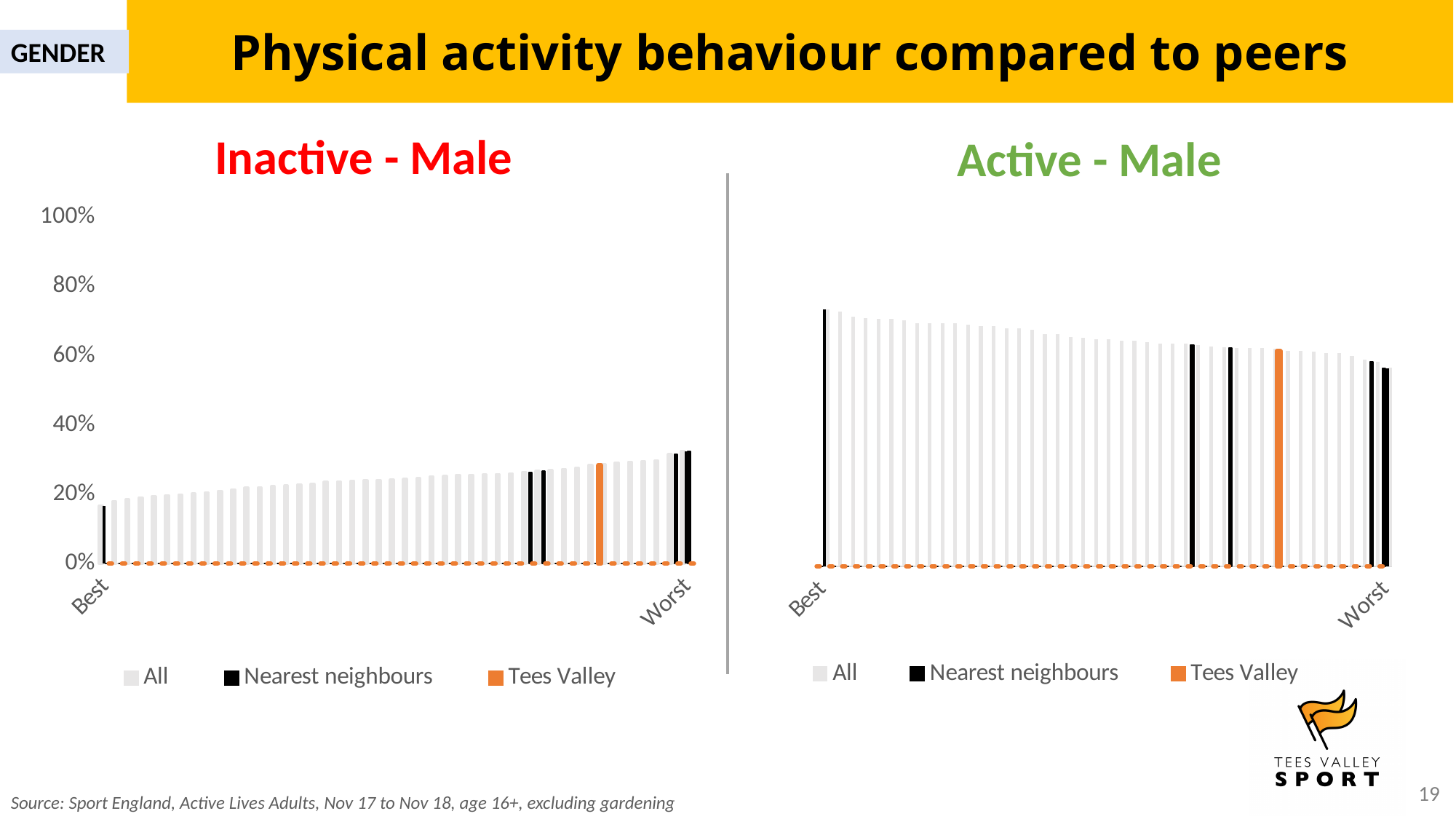
In the Inactive - Male chart, is the value for Tees Valley greater or less than 20%? greater In the Active - Male chart, is the value for the Best area greater or less than 60%? greater In the Active - Male chart, is the value for Tees Valley greater or less than 80%? less How many series does the legend of the Active - Male chart list? 3 What kind of chart is the Inactive - Male chart? bar chart What colour represents Tees Valley in the charts? orange In the Active - Male chart, do the values rise or fall from Best to Worst? fall What are the legend entries on the Inactive - Male chart? All, Nearest neighbours, Tees Valley In the Inactive - Male chart, do the values rise or fall from Best to Worst? rise